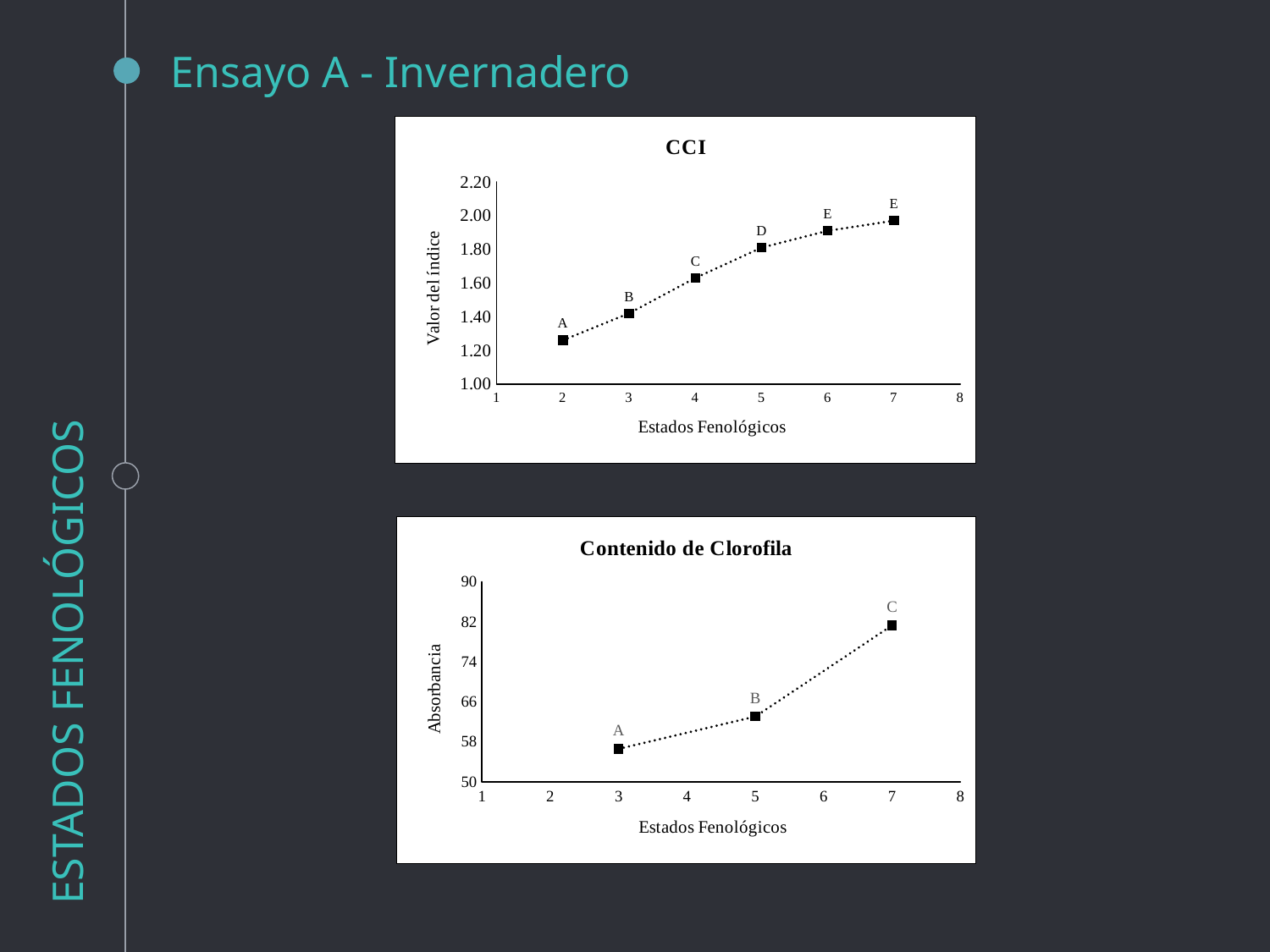
In the Contenido de Clorofila chart, what is the label of the x axis? Estados Fenológicos In the CCI chart, how many data points are plotted? 6 In the CCI chart, what is the label of the y axis? Valor del índice In the CCI chart, which phenological stage has the lowest index value? 2 In the CCI chart, is the value at phenological stage 2 greater or less than 1.40? less In the CCI chart, is the value at phenological stage 5 greater or less than 1.60? greater In the CCI chart, what kind of chart is shown? line chart In the CCI chart, do the values rise or fall as the phenological stage (Estados Fenológicos) increases? rise In the Contenido de Clorofila chart, which phenological stage has the highest absorbance? 7 In the CCI chart, which is larger, the value at stage 4 or the value at stage 6? stage 6 In the Contenido de Clorofila chart, is the value at phenological stage 3 greater or less than 58? less In the Contenido de Clorofila chart, how many data points are plotted? 3